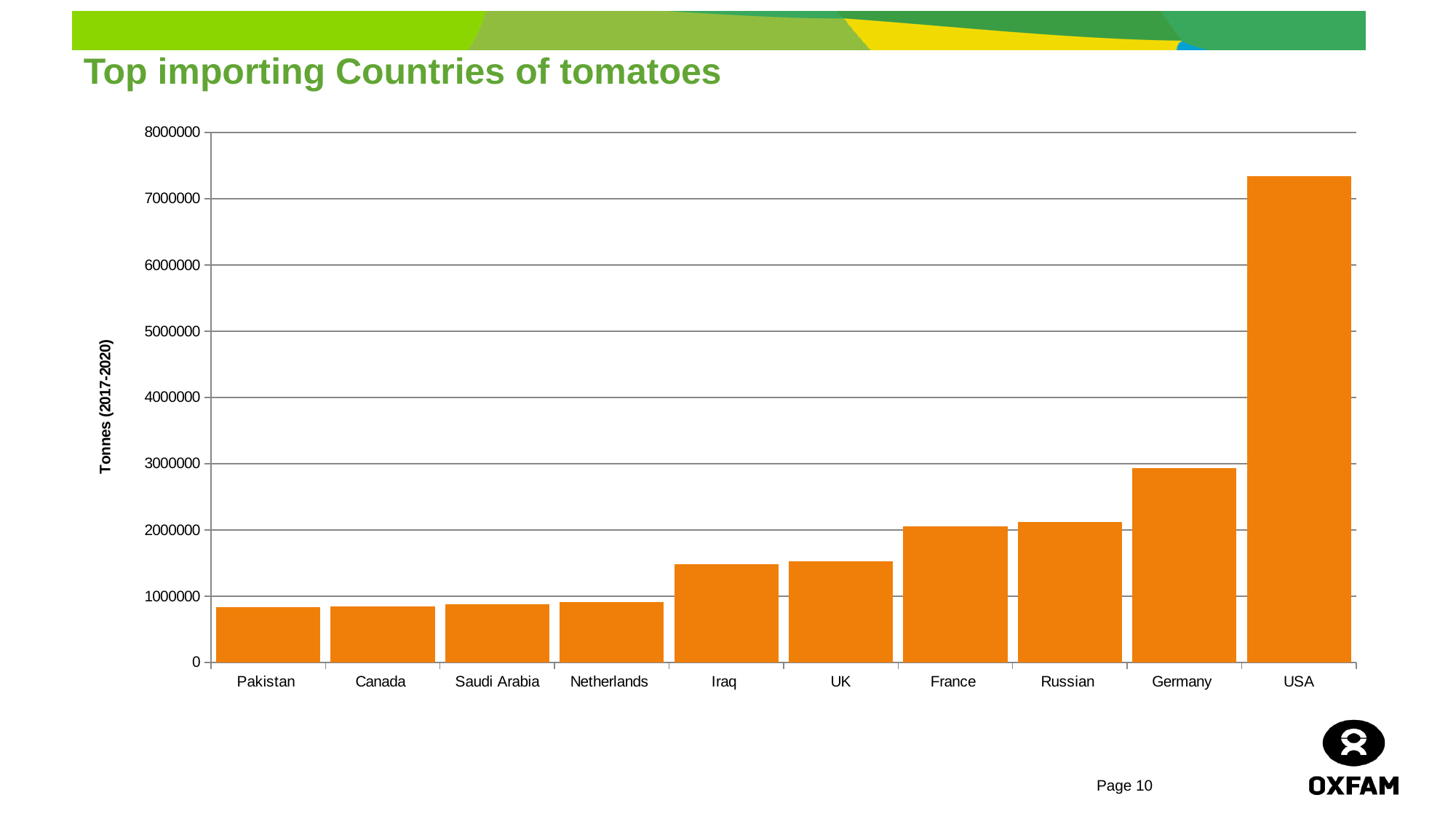
Is the value for USA greater or less than 7000000? greater Is the value for Pakistan greater or less than 1000000? less What is the label on the vertical axis of the chart? Tonnes (2017-2020) Which has a larger value, Netherlands or Iraq? Iraq Is the value for Iraq greater or less than 1000000? greater Which has a larger value, Germany or Russian? Germany Do the values rise or fall moving from left to right along the x axis? rise How many countries are shown on the chart? 10 What kind of chart is shown on the slide? bar chart Which country has the highest value on the chart? USA